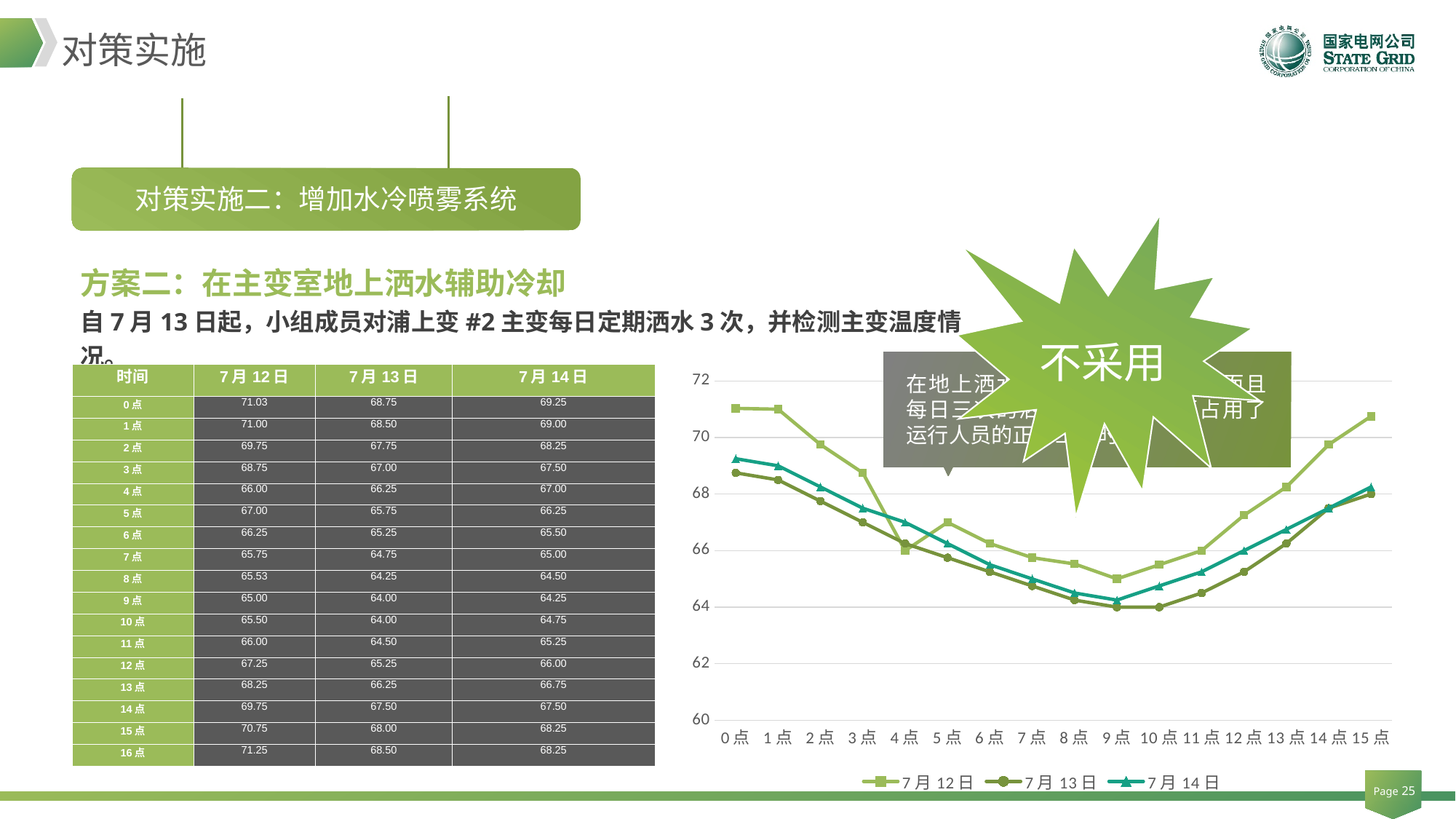
How many series does the chart legend list? 3 Is the value for 7月13日 at 0点 greater or less than 68? greater Is the value for 7月12日 at 9点 greater or less than 66? less Which series is plotted with triangle markers in the chart? 7月14日 How many time points are plotted along the x axis of the chart? 16 What kind of chart is shown on the slide? line chart According to the table, what is the value for 7月13日 at 9点? 64.00 At which time point does the 7月12日 series reach its lowest value? 9点 Do the values of the 7月12日 series rise or fall from 9点 to 15点? rise At 4点, which series has the larger value, 7月12日 or 7月14日? 7月14日 Is the value for 7月12日 at 15点 greater or less than 70? greater At 15点, which series has the larger value, 7月12日 or 7月13日? 7月12日